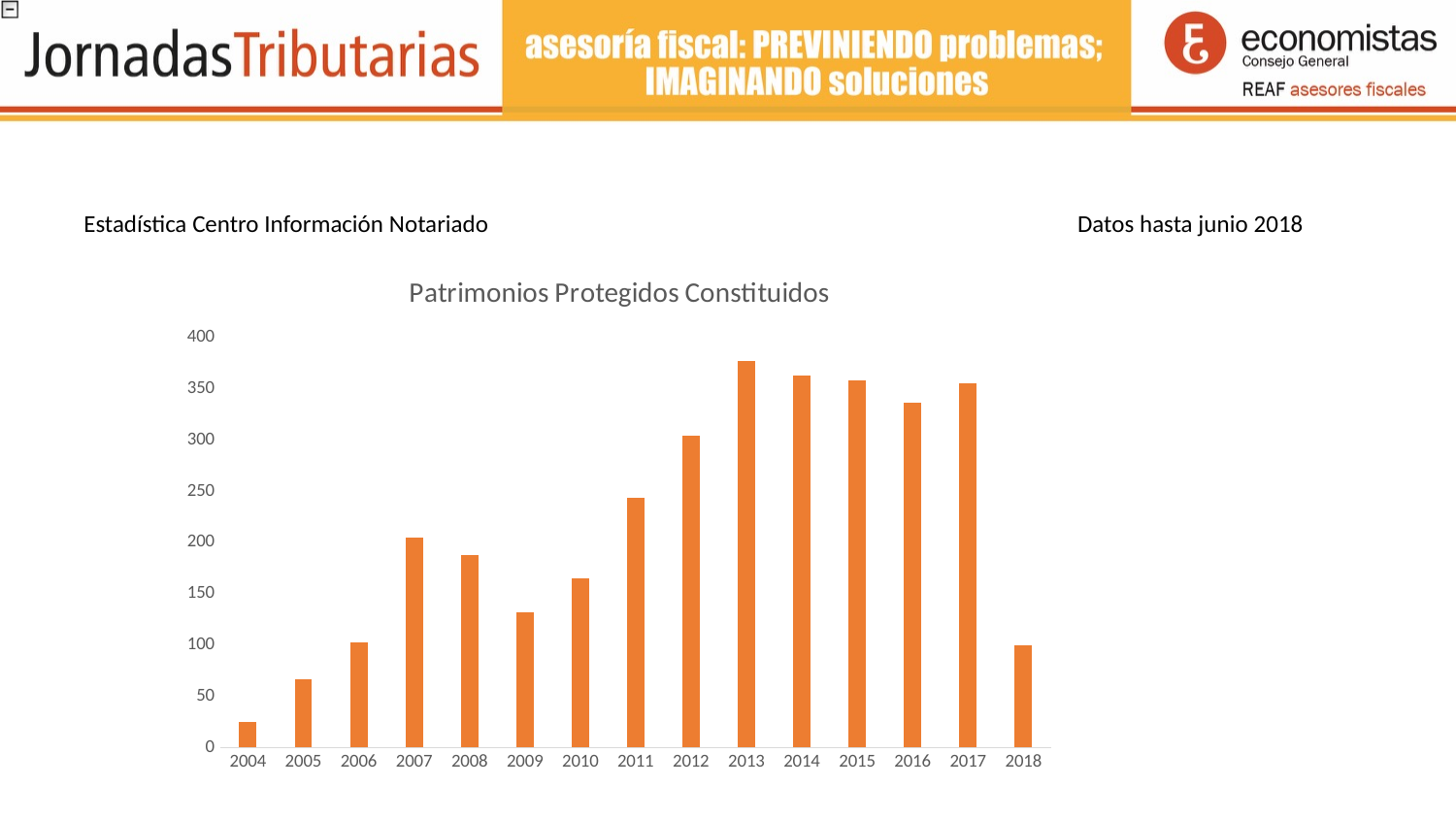
Is the value for 2009 greater or less than 100? greater Is the value for 2016 greater or less than 300? greater Is the value for 2018 greater or less than 150? less What is the title of the chart? Patrimonios Protegidos Constituidos Which year has the lowest value in the chart? 2004 Which year has the highest value in the chart? 2013 Which year has the larger value, 2007 or 2008? 2007 How many years are shown on the x axis of the chart? 15 Do the values rise or fall from 2004 to 2013? rise What kind of chart is shown on the slide? Bar chart